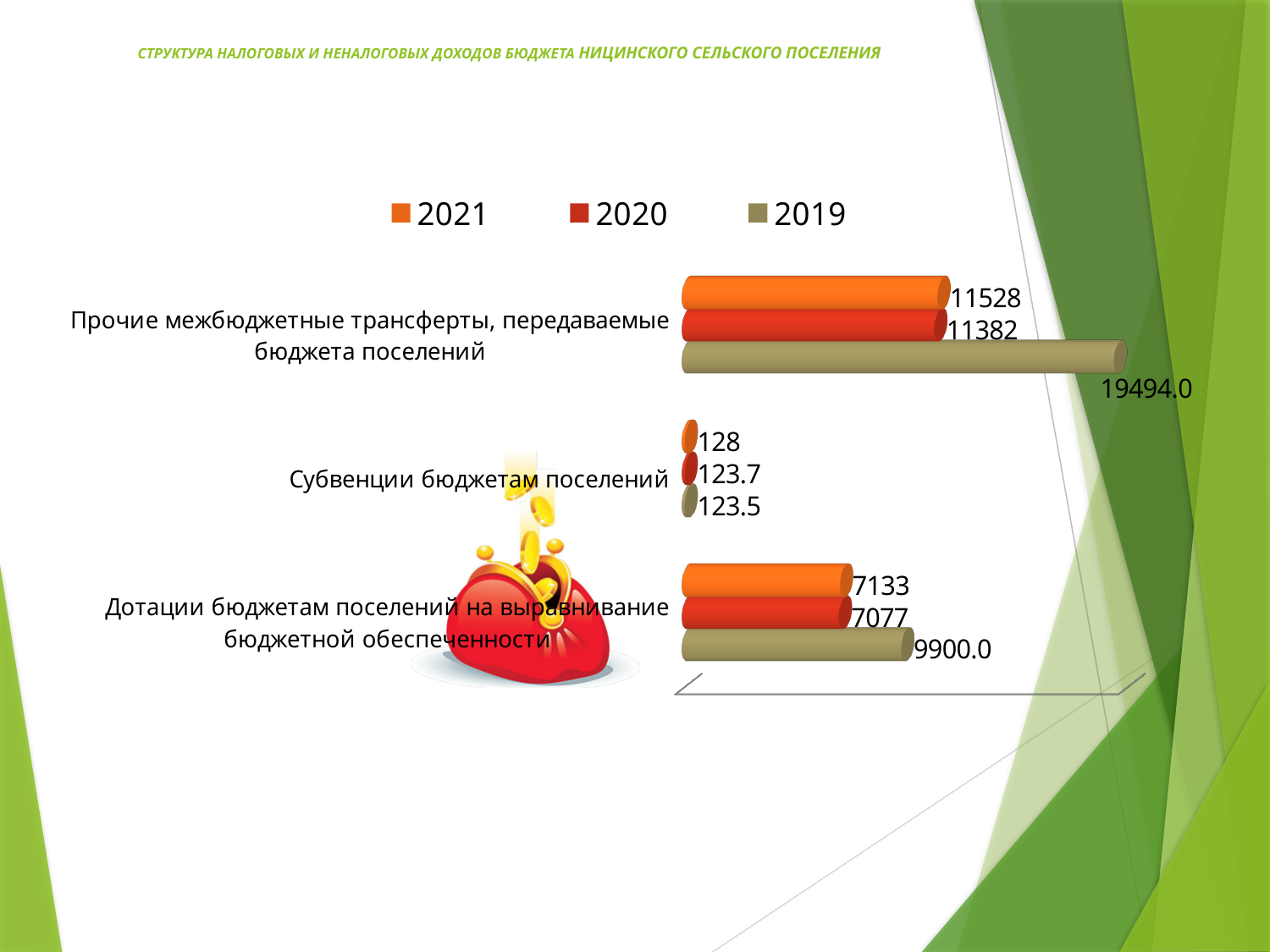
What type of chart is shown on the slide? bar chart What is the 2021 value for 'Прочие межбюджетные трансферты, передаваемые бюджета поселений'? 11528 What is the difference between the 2019 and 2021 values for 'Дотации бюджетам поселений на выравнивание бюджетной обеспеченности'? 2767 What is the 2019 value for 'Дотации бюджетам поселений на выравнивание бюджетной обеспеченности'? 9900.0 Which category has the highest 2021 value? Прочие межбюджетные трансферты, передаваемые бюджета поселений What is the 2019 value for 'Прочие межбюджетные трансферты, передаваемые бюджета поселений'? 19494.0 For 'Прочие межбюджетные трансферты, передаваемые бюджета поселений', which year has the larger value, 2020 or 2019? 2019 How many series does the legend list? 3 Which legend entry is shown in orange? 2021 What is the 2020 value for 'Субвенции бюджетам поселений'? 123.7 How many categories are shown on the chart? 3 Which category has the lowest 2019 value? Субвенции бюджетам поселений